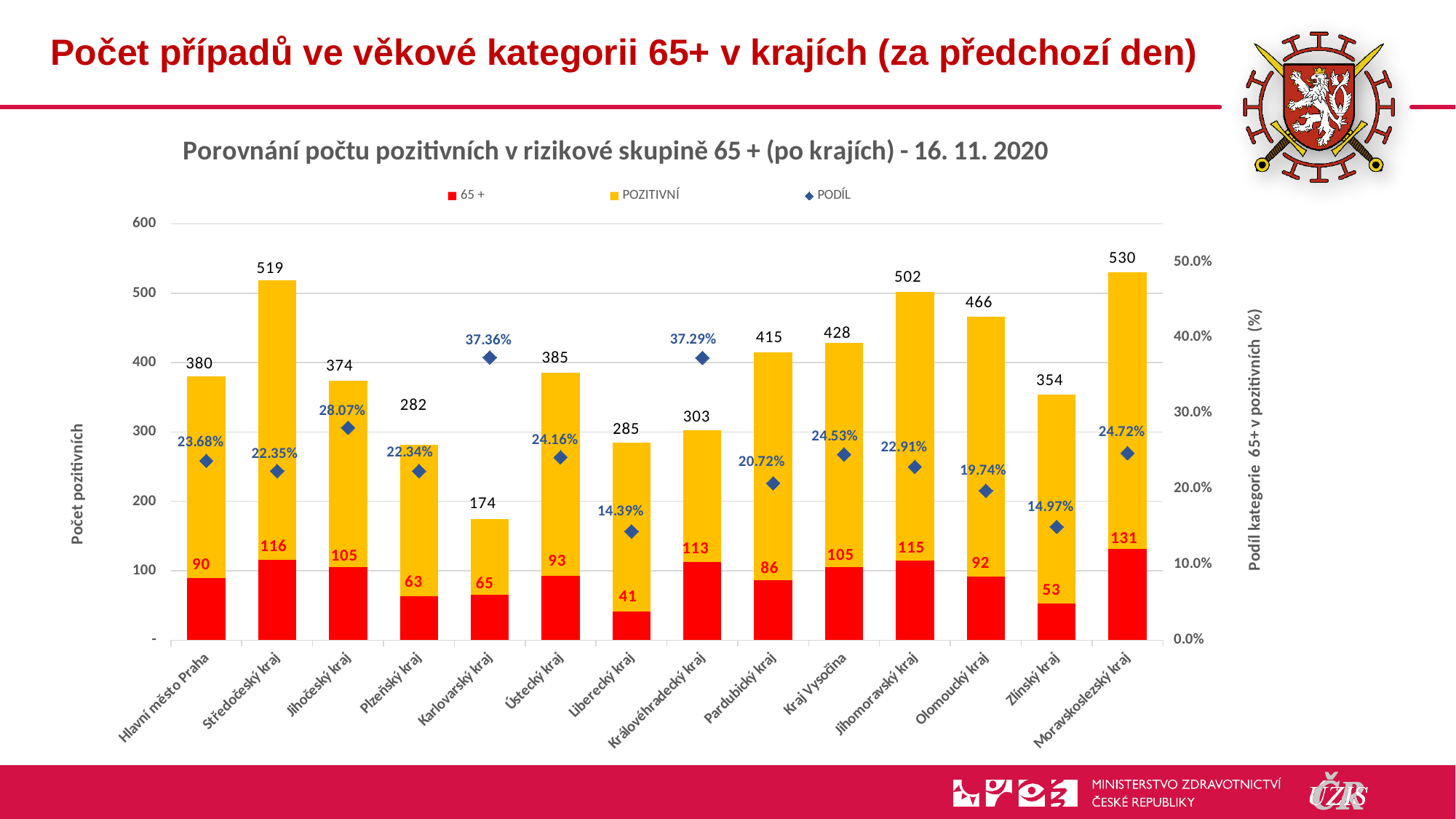
How many regions are shown on the x axis? 14 What is the PODÍL value for Karlovarský kraj? 37.36% What date is given in the chart title? 16. 11. 2020 What is the 65 + value for Královéhradecký kraj? 113 Is the POZITIVNÍ value for Zlínský kraj greater or less than 400? less Which region has the lowest PODÍL value? Liberecký kraj What is the difference between the POZITIVNÍ values for Jihomoravský kraj and Olomoucký kraj? 36 What is the POZITIVNÍ value for Středočeský kraj? 519 Which is larger, the 65 + value for Plzeňský kraj or for Karlovarský kraj? Karlovarský kraj Which region has the lowest 65 + value? Liberecký kraj How many series does the legend list? 3 Which region has the highest POZITIVNÍ value? Moravskoslezský kraj